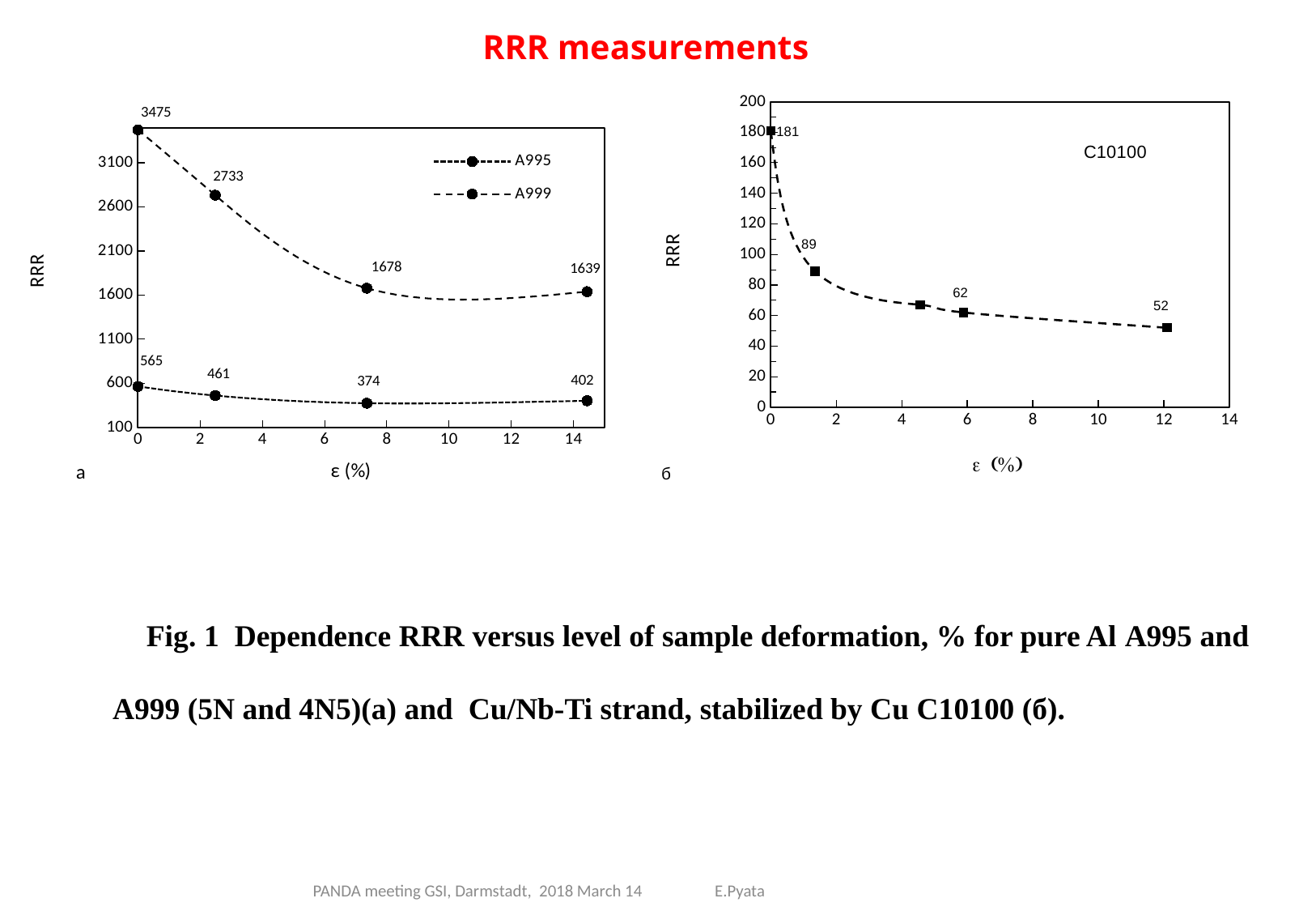
What kind of chart is the left chart (a)? Line chart In the right chart (б), is the value of the unlabelled third data point greater or less than 80? less In the left chart (a), what is the difference between the first two labelled A999 values, 3475 and 2733? 742 In the left chart (a), what is the highest labelled RRR value of the A999 series? 3475 In the right chart (б), what is the RRR value of the last data point, at about ε = 12? 52 In the left chart (a), what is the RRR value of the first A999 data point, at ε = 0? 3475 How many data points are plotted in the right chart (б)? 5 In the left chart (a), what is the lowest labelled RRR value of the A995 series? 374 In the left chart (a), does the A999 series generally rise or fall as ε increases? Fall How many series does the legend of the left chart (a) list? 2 In the left chart (a), what is the RRR value of the first A995 data point, at ε = 0? 565 In the right chart (б), what is the RRR value of the first data point, at ε = 0? 181